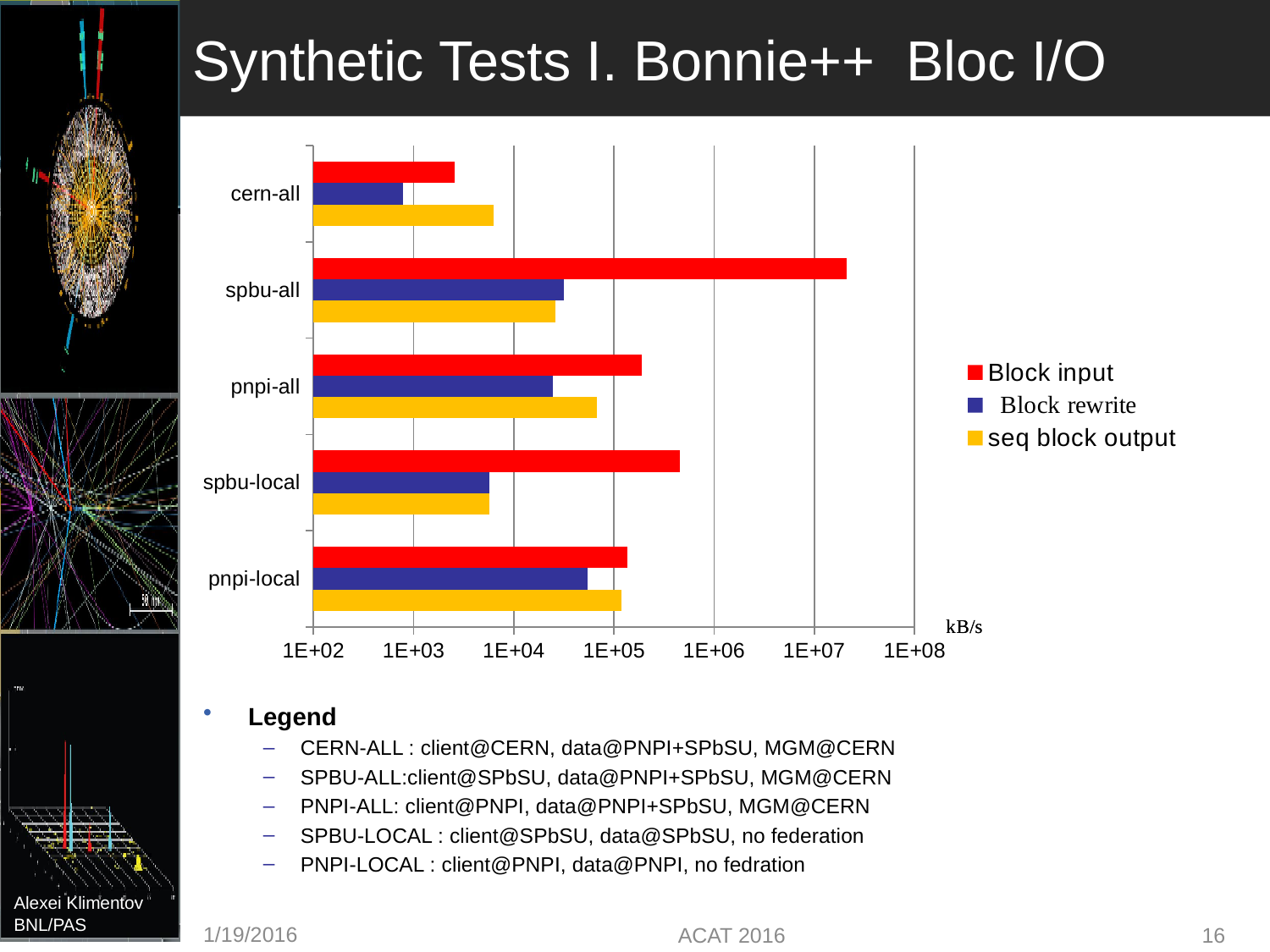
Is the Block rewrite value for cern-all greater or less than 1E+03? less Which category has the highest Block input value? spbu-all Which category has the lowest Block input value? cern-all What unit is shown at the end of the x axis of the chart? kB/s What kind of chart is shown on the slide? bar chart Is the Block input value for spbu-local greater or less than 1E+05? greater Is the Block input value for spbu-all greater or less than 1E+07? greater Which has the larger Block input value: spbu-all or pnpi-all? spbu-all How many categories are plotted on the y axis of the chart? 5 For cern-all, which is larger: Block input or seq block output? seq block output How many series does the chart legend list? 3